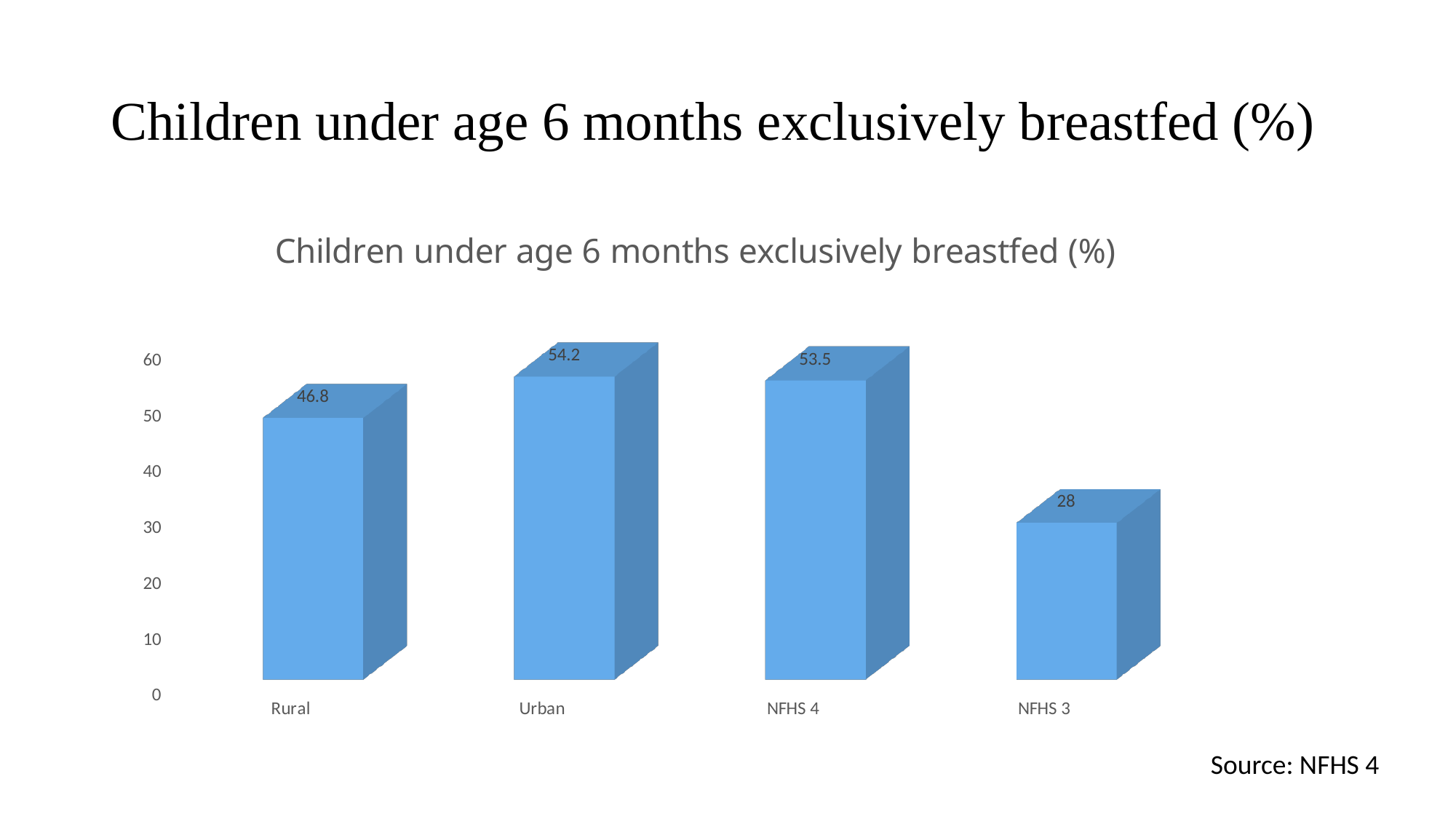
What is the value for NFHS 4? 53.5 What kind of chart is shown on the slide? bar chart What is the value for Rural? 46.8 Which category has the lowest value? NFHS 3 What is the difference between the Urban and Rural values? 7.4 Which category has the highest value? Urban How many categories are shown on the chart? 4 What is the difference between the NFHS 4 and NFHS 3 values? 25.5 Which is larger, the value for Rural or the value for NFHS 3? Rural Is the value for NFHS 3 greater or less than 30? less What is the value for NFHS 3? 28 What is the value for Urban? 54.2